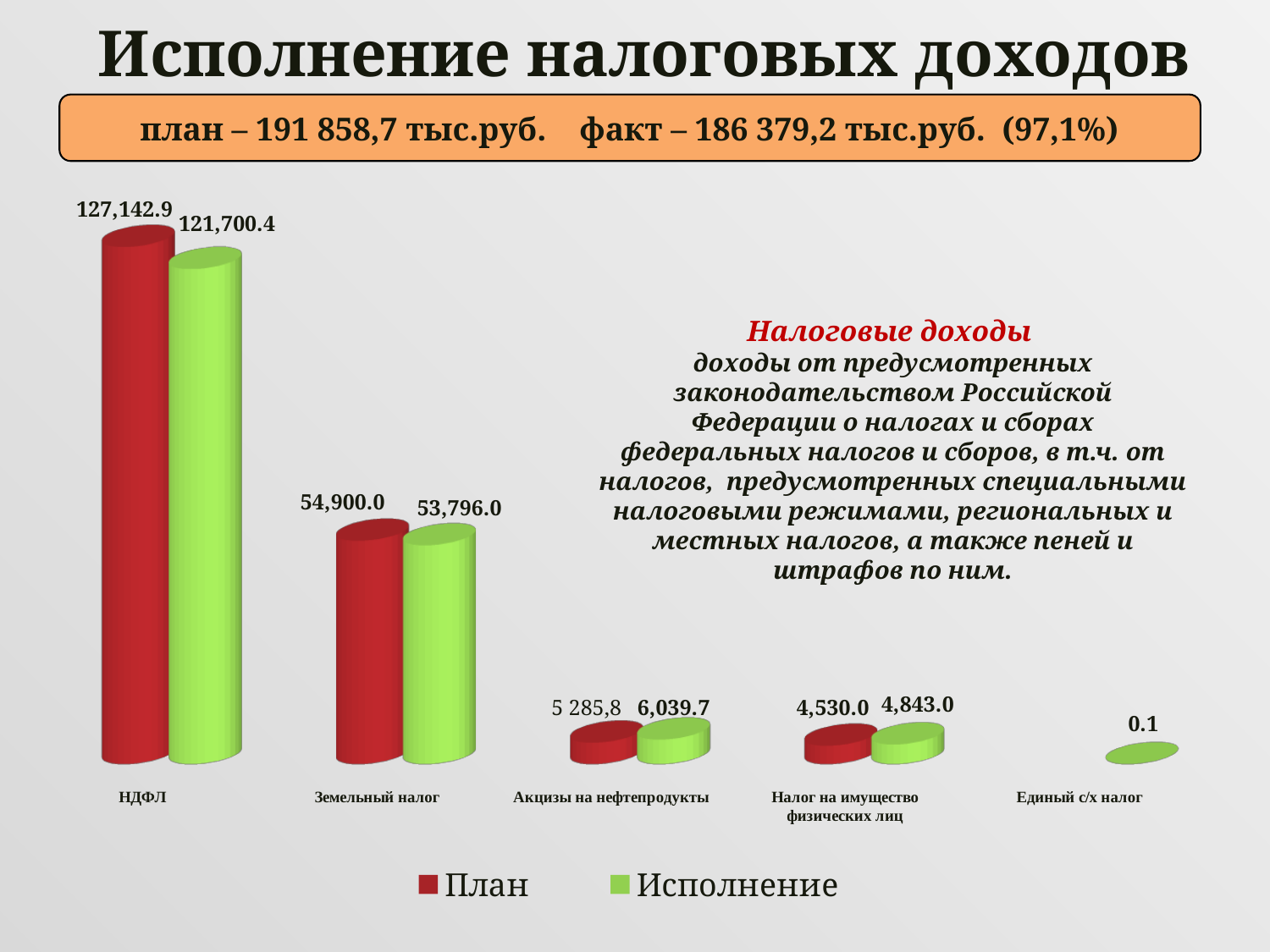
For Акцизы на нефтепродукты, which is larger: План or Исполнение? Исполнение Which category has the lowest Исполнение value? Единый с/х налог What is the Исполнение value for Земельный налог? 53,796.0 What kind of chart is shown on the slide? Bar chart Which category has the highest Исполнение value? НДФЛ How many series does the legend list? 2 What is the План value for НДФЛ? 127,142.9 What is the difference between the Исполнение and План values for Налог на имущество физических лиц? 313.0 What is the difference between the План and Исполнение values for НДФЛ? 5,442.5 What is the Исполнение value for Акцизы на нефтепродукты? 6,039.7 What is the План value for Налог на имущество физических лиц? 4,530.0 What is the Исполнение value for Единый с/х налог? 0.1